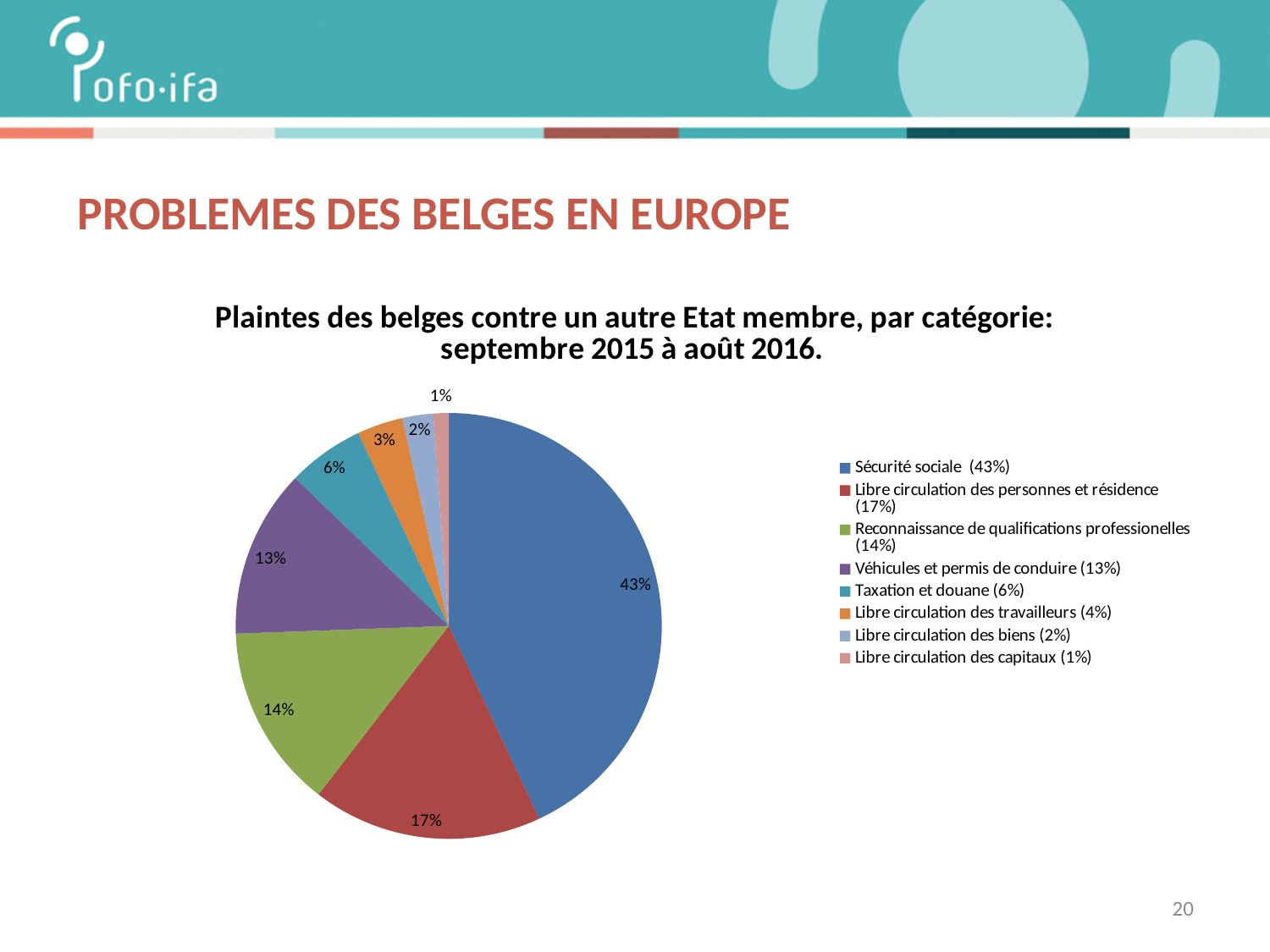
What is the difference in percentage points between Sécurité sociale and Libre circulation des personnes et résidence? 26 percentage points What is the title of the chart? Plaintes des belges contre un autre Etat membre, par catégorie: septembre 2015 à août 2016. Which category has the smallest slice of the pie? Libre circulation des capitaux Which is larger, the slice for Véhicules et permis de conduire or the slice for Taxation et douane? Véhicules et permis de conduire What share of the pie does Véhicules et permis de conduire represent? 13% What share of the pie does Sécurité sociale represent? 43% What share of the pie does Libre circulation des personnes et résidence represent? 17% How many categories does the legend list? 8 What type of chart is shown on the slide? pie chart Which category has the largest slice of the pie? Sécurité sociale